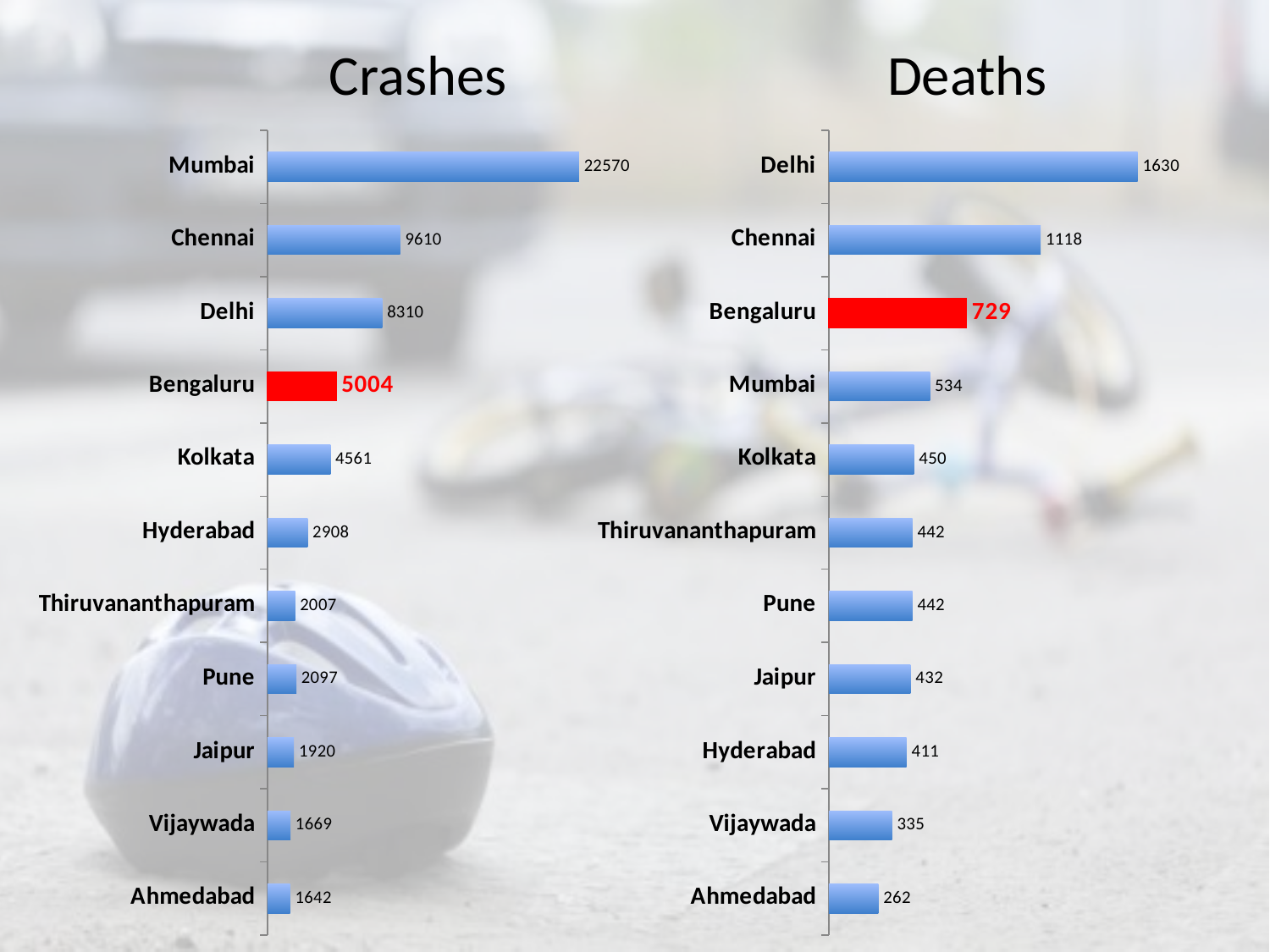
In the Deaths chart, which city's bar is highlighted in red? Bengaluru In the Deaths chart, what is the difference between Delhi and Chennai? 512 How many cities are shown in the Crashes chart? 11 In the Deaths chart, which is larger, Mumbai or Ahmedabad? Mumbai In the Crashes chart, which is larger, Kolkata or Hyderabad? Kolkata What kind of chart is the Deaths chart? Bar chart In the Crashes chart, what is the value for Thiruvananthapuram? 2007 In the Crashes chart, which city has the lowest value? Ahmedabad In the Crashes chart, what is the difference between Chennai and Delhi? 1300 In the Crashes chart, what is the value for Mumbai? 22570 In the Deaths chart, which city has the highest value? Delhi In the Deaths chart, what is the value for Bengaluru? 729